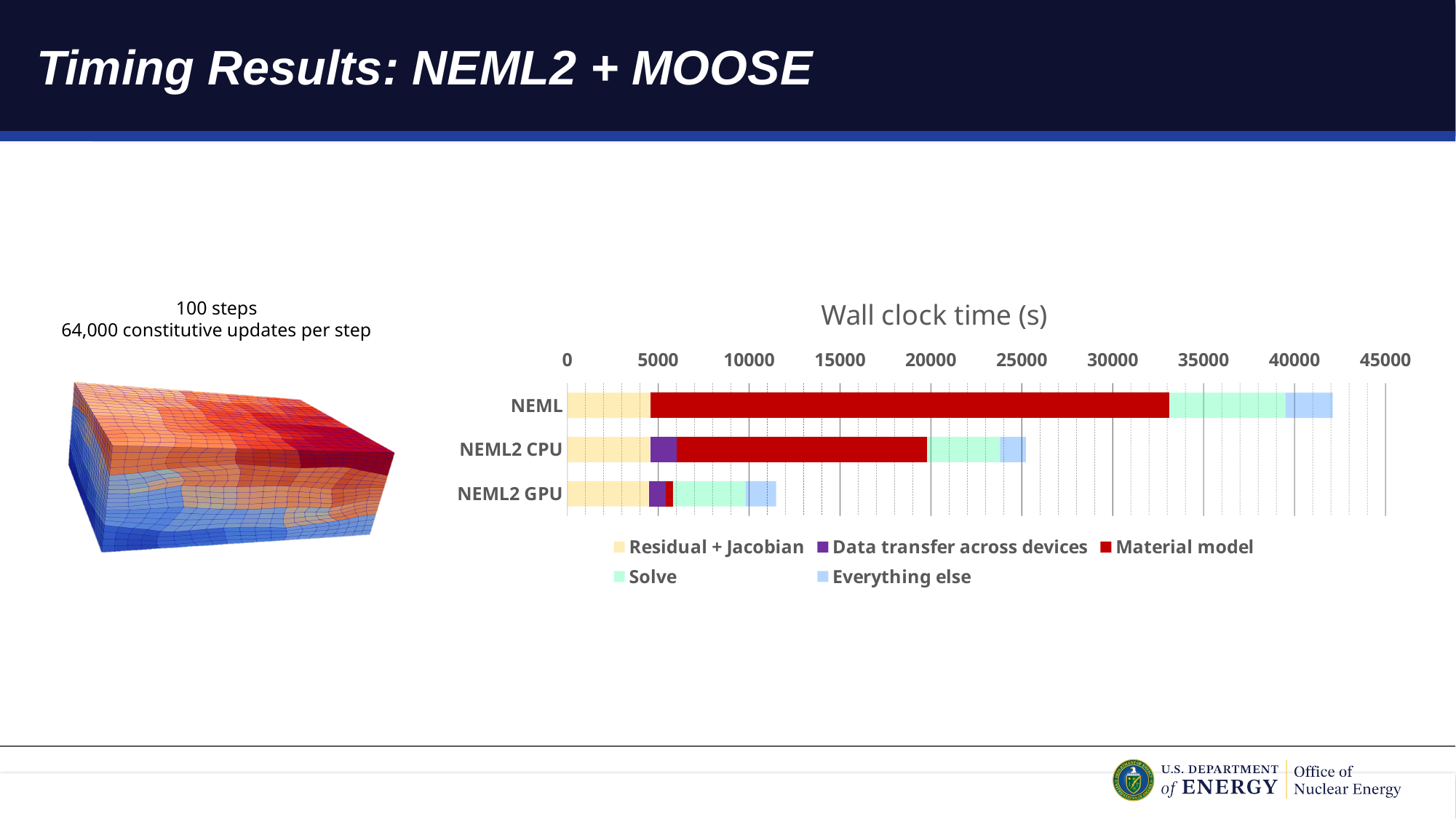
Is the total wall clock time for NEML2 CPU greater or less than 20000? greater What is the title of the chart? Wall clock time (s) Is the total wall clock time for NEML2 GPU greater or less than 15000? less Which has a larger total wall clock time, NEML2 CPU or NEML2 GPU? NEML2 CPU How many categories (bars) are plotted in the chart? 3 How many series does the chart legend list? 5 Which series is shown in red in the chart legend? Material model Which category has the longest total bar in the chart? NEML What type of chart is shown on the slide? Stacked bar chart Is the Material model segment for NEML greater or less than 25000? greater Which category has the shortest total bar in the chart? NEML2 GPU